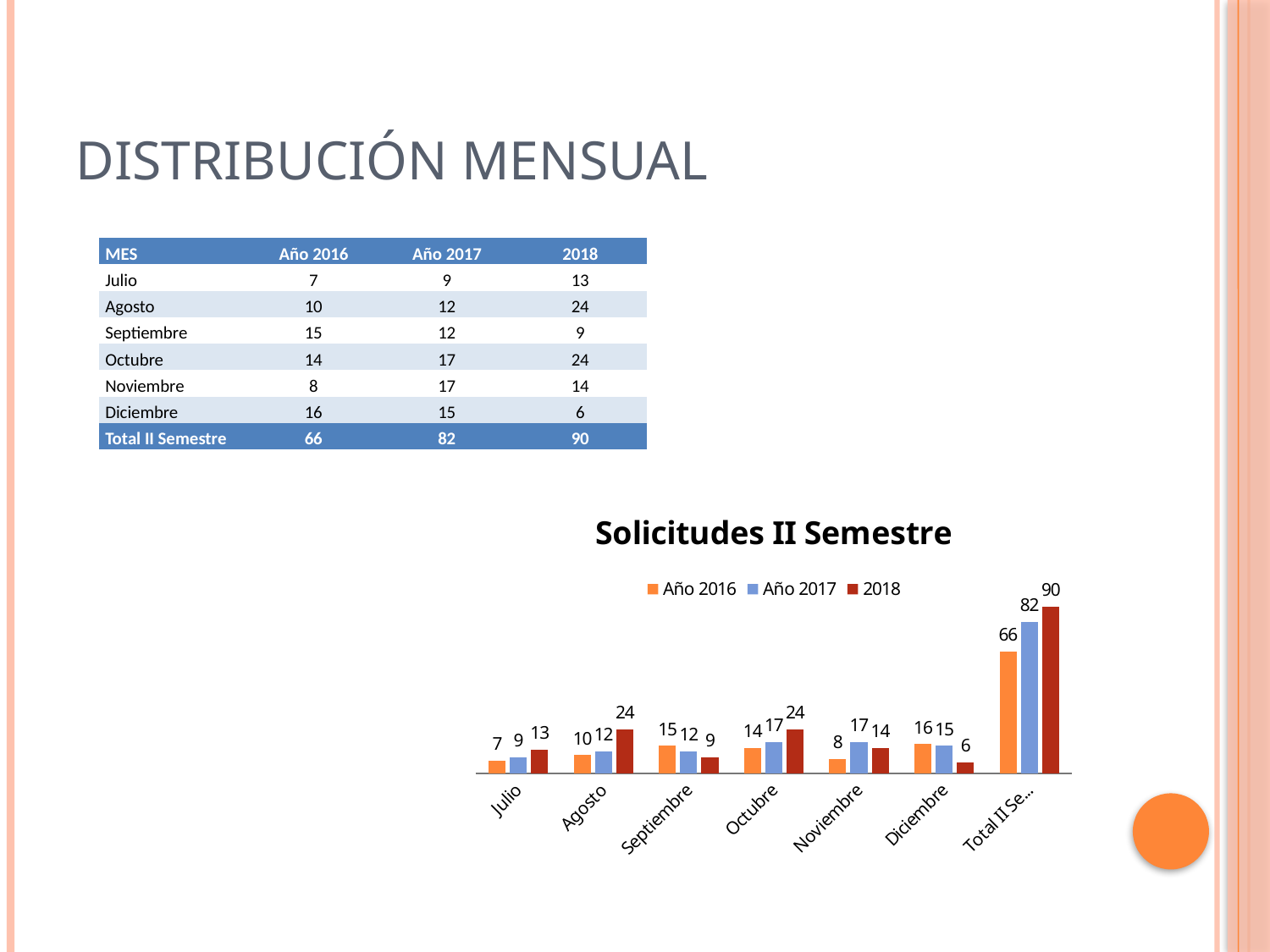
What is the value for 2018 in Agosto? 24 What kind of chart is shown on the slide? bar chart Which series has the highest Total II Semestre value? 2018 Which month has the highest value for Año 2016 (excluding the total)? Diciembre What is the difference between the 2018 and Año 2016 values for Agosto? 14 What is the value for Año 2017 in Octubre? 17 How many series does the chart legend list? 3 What is the value for Año 2016 in Diciembre? 16 What is the difference between the Total II Semestre values for 2018 and Año 2017? 8 Which month has the lowest value for 2018? Diciembre Which is larger in Noviembre, the Año 2016 value or the Año 2017 value? Año 2017 What is the title of the chart? Solicitudes II Semestre